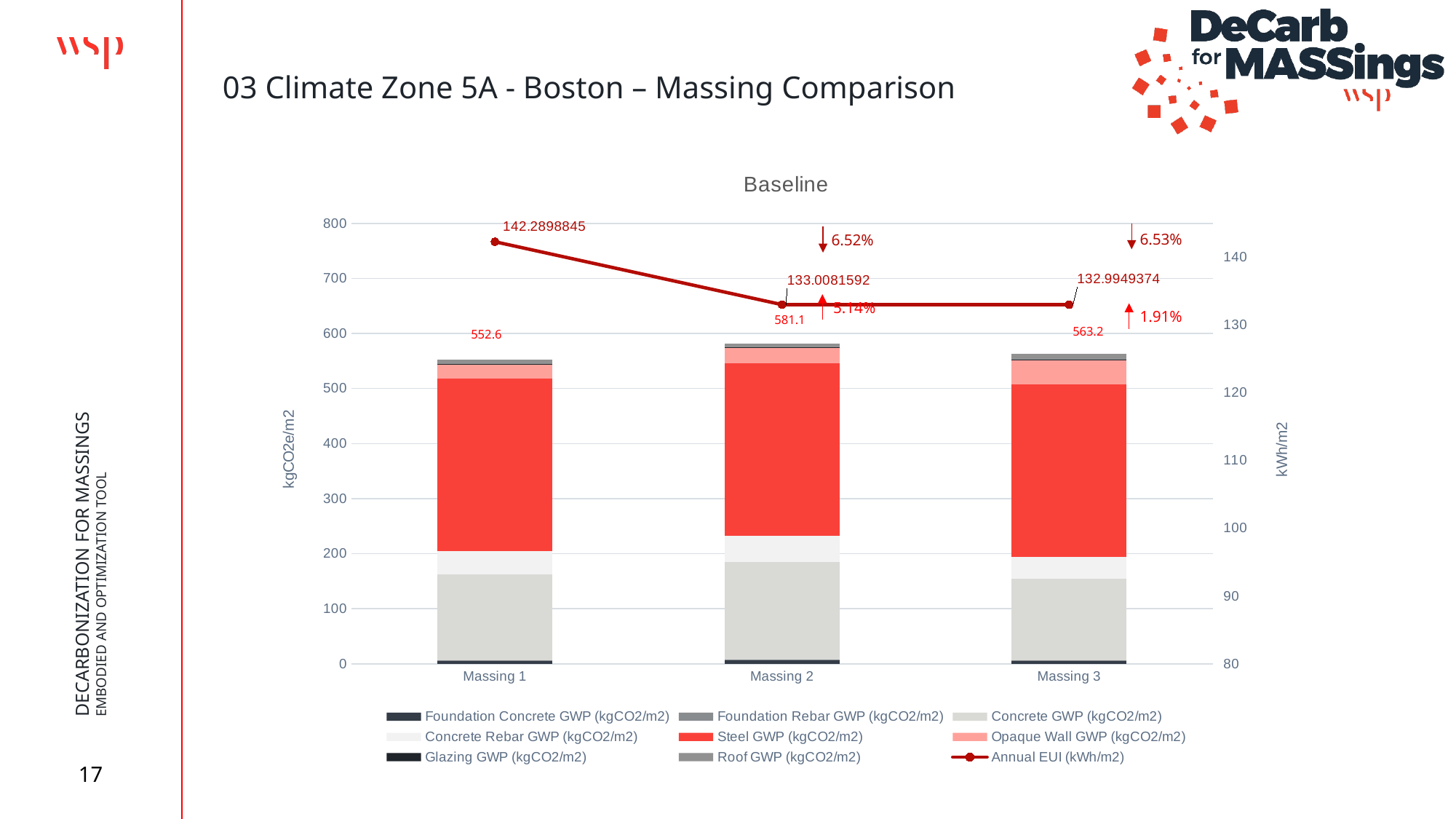
Which has a higher Annual EUI, Massing 1 or Massing 2? Massing 1 Which massing has the lowest total embodied carbon (kgCO2e/m2)? Massing 1 How many massing categories are shown on the x axis? 3 What is the total embodied carbon value labelled for Massing 2? 581.1 What is the title of the chart? Baseline What is the total embodied carbon value labelled for Massing 1? 552.6 Does the Annual EUI line rise or fall from Massing 1 to Massing 2? fall What is the Annual EUI value labelled for Massing 1? 142.2898845 What is the difference between the total embodied carbon of Massing 2 and Massing 1? 28.5 Which massing has the highest total embodied carbon (kgCO2e/m2)? Massing 2 What is the Annual EUI value labelled for Massing 3? 132.9949374 How many series does the legend list? 9